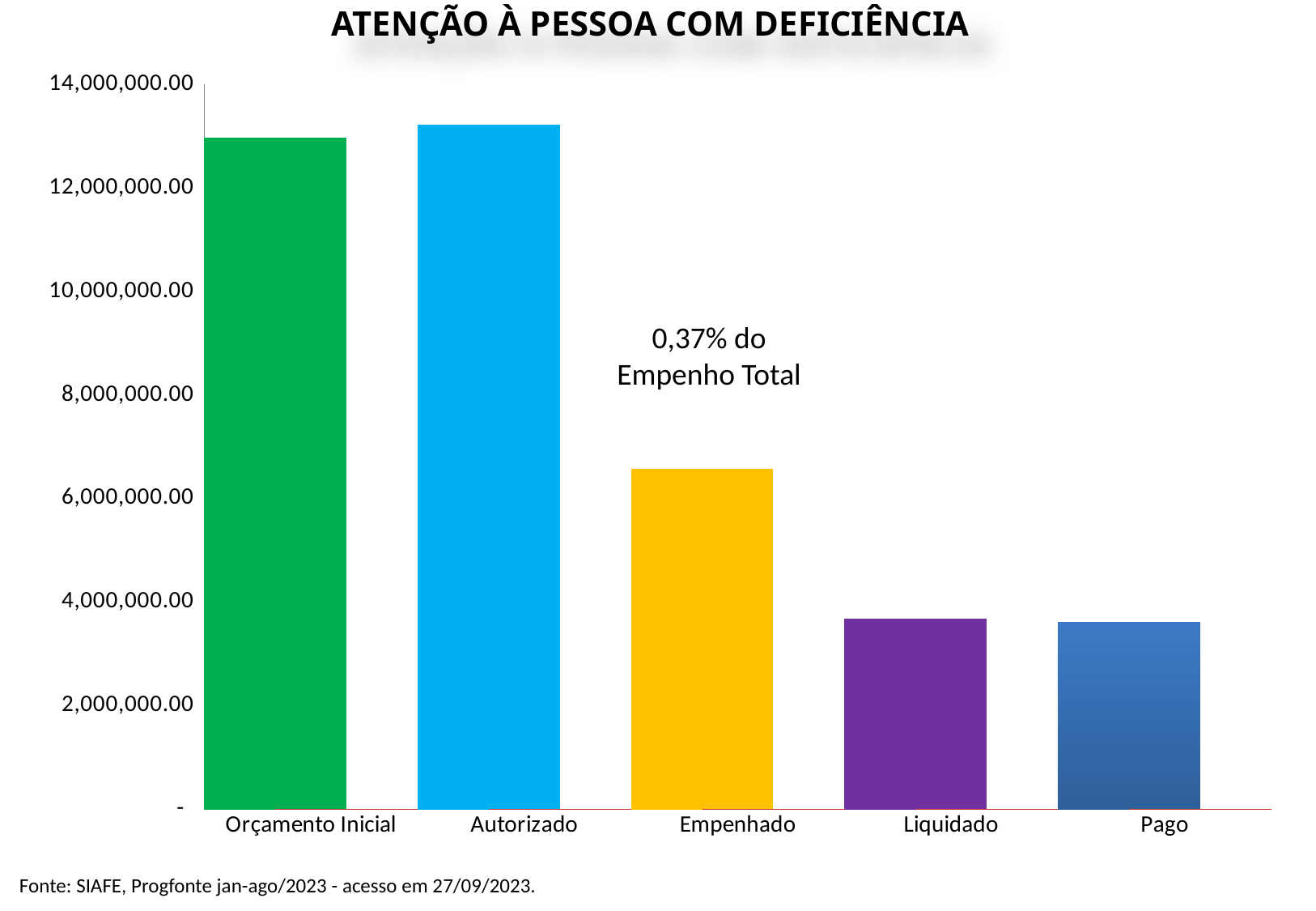
What kind of chart is shown on the slide? bar chart Do the values generally rise or fall from left to right across the categories? fall Is the value for Orçamento Inicial greater or less than 12,000,000.00? greater What percentage of the Empenho Total does the annotation on the chart state? 0,37% Which category has the highest value? Autorizado Which is larger, Autorizado or Orçamento Inicial? Autorizado Is the value for Empenhado greater or less than 6,000,000.00? greater Is the value for Pago greater or less than 4,000,000.00? less How many categories are plotted on the chart? 5 Which is larger, Empenhado or Liquidado? Empenhado What is the title of the chart? ATENÇÃO À PESSOA COM DEFICIÊNCIA